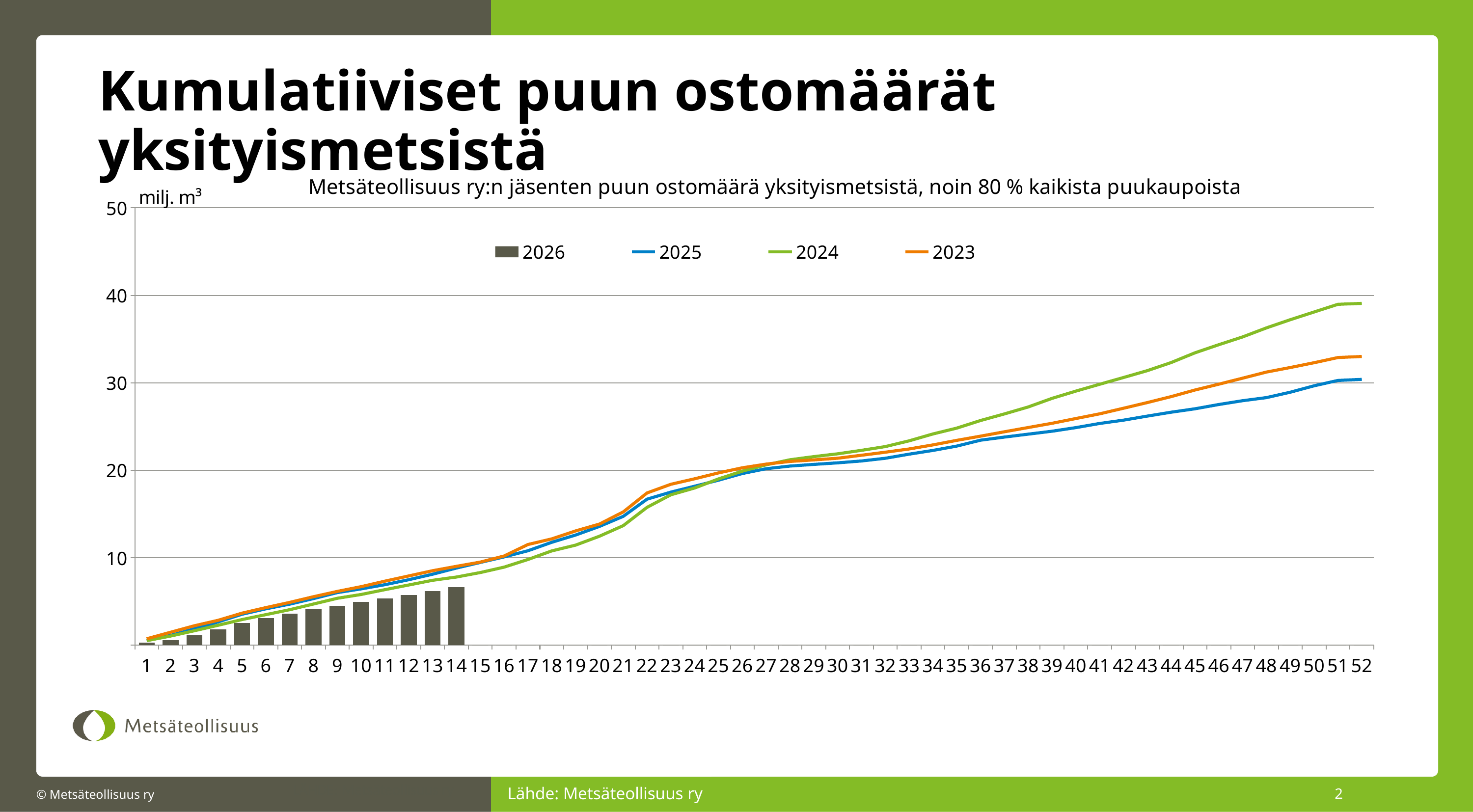
Do the values of the 2025 line rise or fall from week 1 to week 52? rise Up to which week are bars plotted for the 2026 series? 14 Which series is drawn as bars rather than a line? 2026 Is the value for the 2026 bar at week 14 greater or less than 10? less Is the value for 2024 at week 52 greater or less than 30? greater How many weeks are labelled along the x axis? 52 What unit is shown on the y axis of the chart? milj. m³ How many series does the chart legend list? 4 Which series has the highest value at week 52? 2024 Which series has the lowest value at week 52? 2025 What kind of chart is shown on the slide? A combined bar and line chart At week 52, is the value for 2023 larger or smaller than the value for 2025? larger